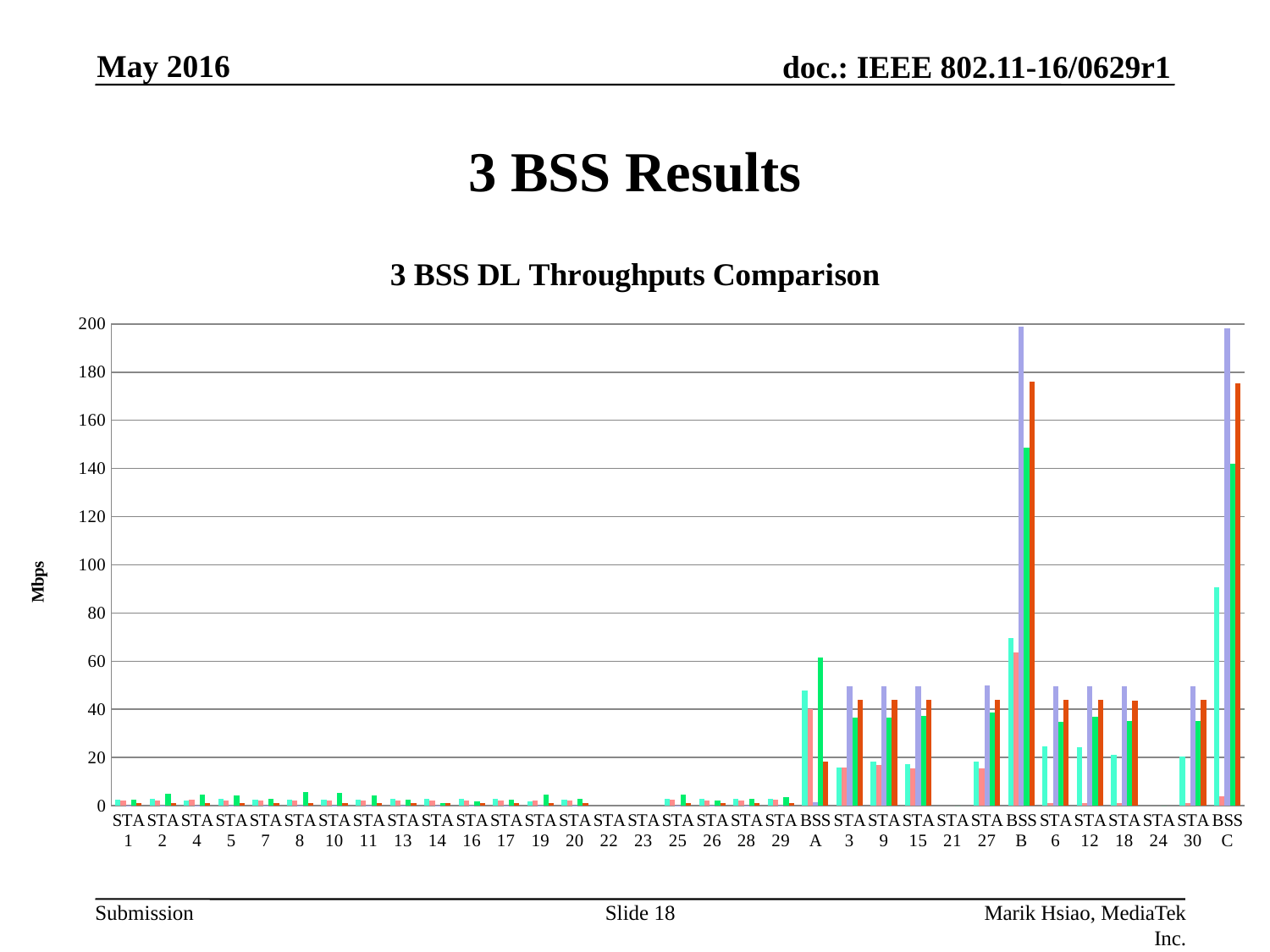
Which has the taller tallest bar, BSS A or BSS B? BSS B What is the title of the chart? 3 BSS DL Throughputs Comparison Is the tallest bar for STA 1 greater or less than 20 Mbps? less Which category has the tallest bar in the chart? BSS B Is the red bar for BSS C greater or less than 160 Mbps? greater Is the tallest bar for BSS A greater or less than 80 Mbps? less What kind of chart is shown on the slide? bar chart What unit is shown on the vertical axis label of the chart? Mbps How many categories are shown along the x axis of the chart? 33